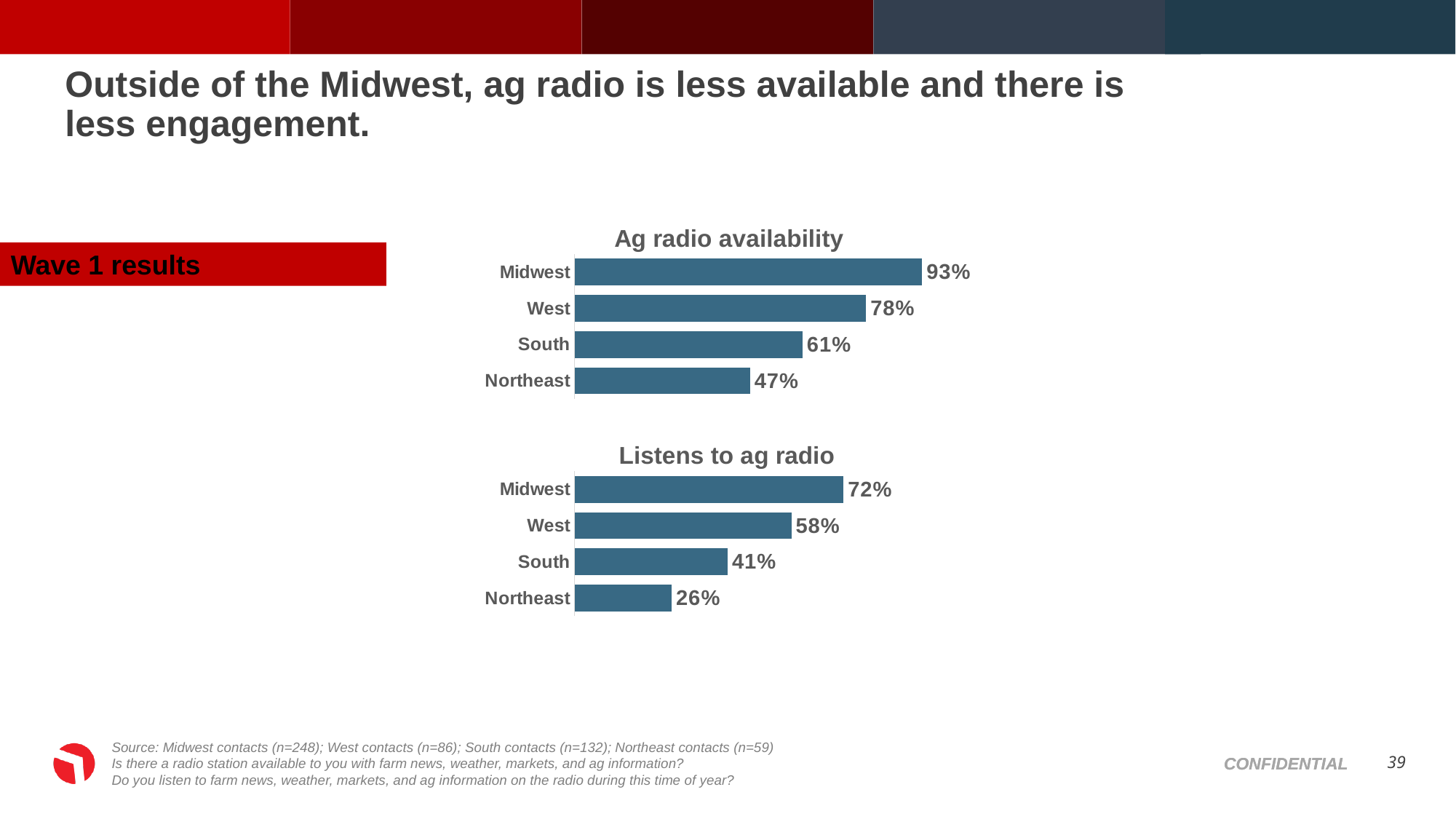
In the 'Ag radio availability' chart, do the values rise or fall going from Midwest down to Northeast? Fall In the 'Listens to ag radio' chart, which region has the highest value? Midwest What is the title of the upper chart on the slide? Ag radio availability In the 'Listens to ag radio' chart, what is the difference between the West and the South values? 17 percentage points In the 'Ag radio availability' chart, what is the value for the Midwest? 93% In the 'Ag radio availability' chart, what is the difference between the Midwest and the Northeast values? 46 percentage points In the 'Listens to ag radio' chart, what is the value for the South? 41% In the 'Listens to ag radio' chart, which is larger, the value for the West or the value for the Northeast? West How many regions are shown in the 'Ag radio availability' chart? 4 What kind of chart is the 'Listens to ag radio' chart? Bar chart In the 'Ag radio availability' chart, what is the value for the West? 78% In the 'Ag radio availability' chart, which region has the lowest value? Northeast